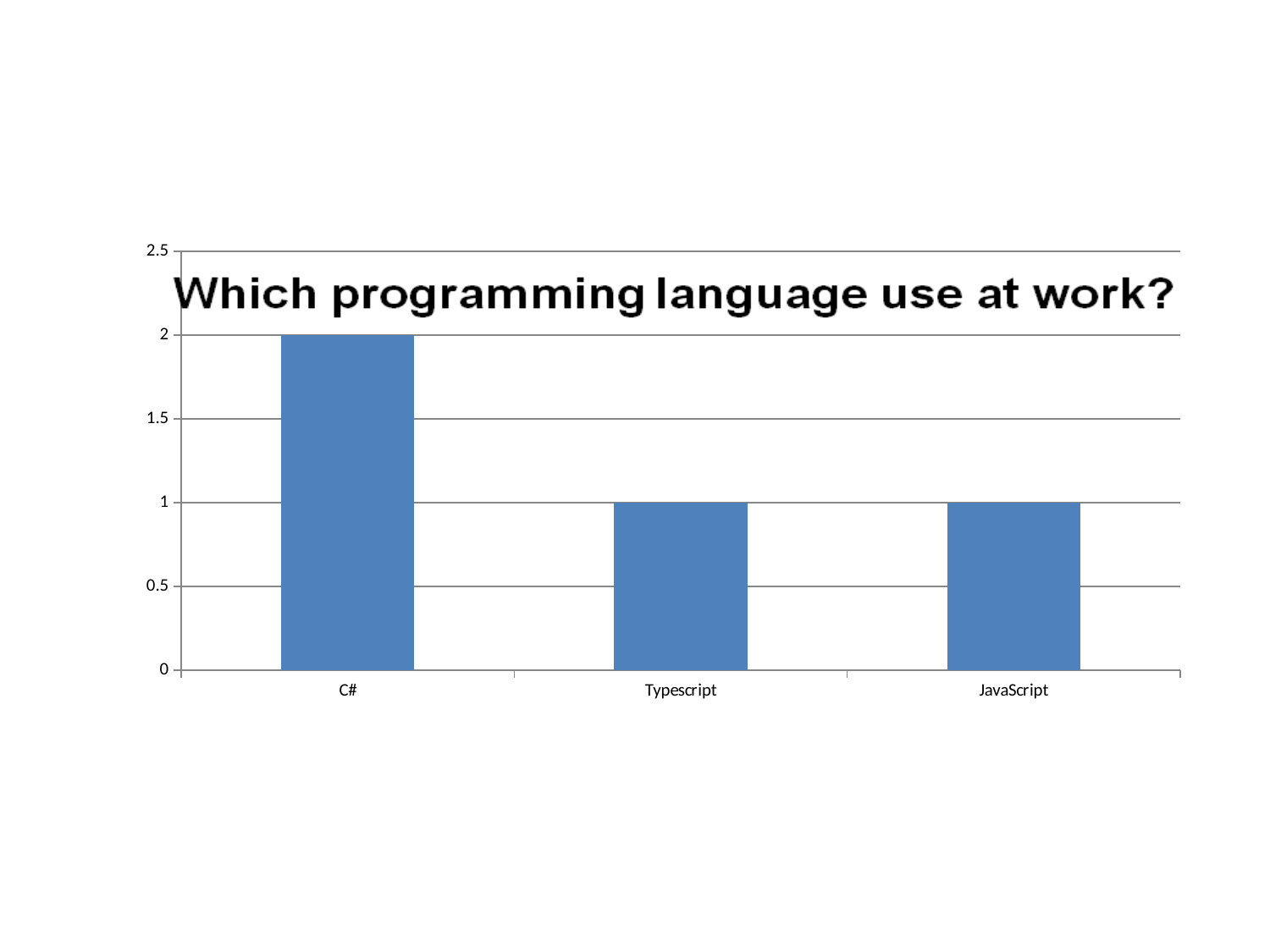
Which is larger, the value for C# or the value for JavaScript? C# Is the value for C# greater or less than 1.5? greater What kind of chart is shown? bar chart What is the highest value shown on the y axis? 2.5 What is the difference between the values for C# and Typescript? 1 Is the value for Typescript greater or less than 1.5? less What is the value for Typescript? 1 Which category has the highest value? C# How many categories are shown on the x axis? 3 What is the value for JavaScript? 1 What is the value for C#? 2 What is the title of the chart? Which programming language use at work?